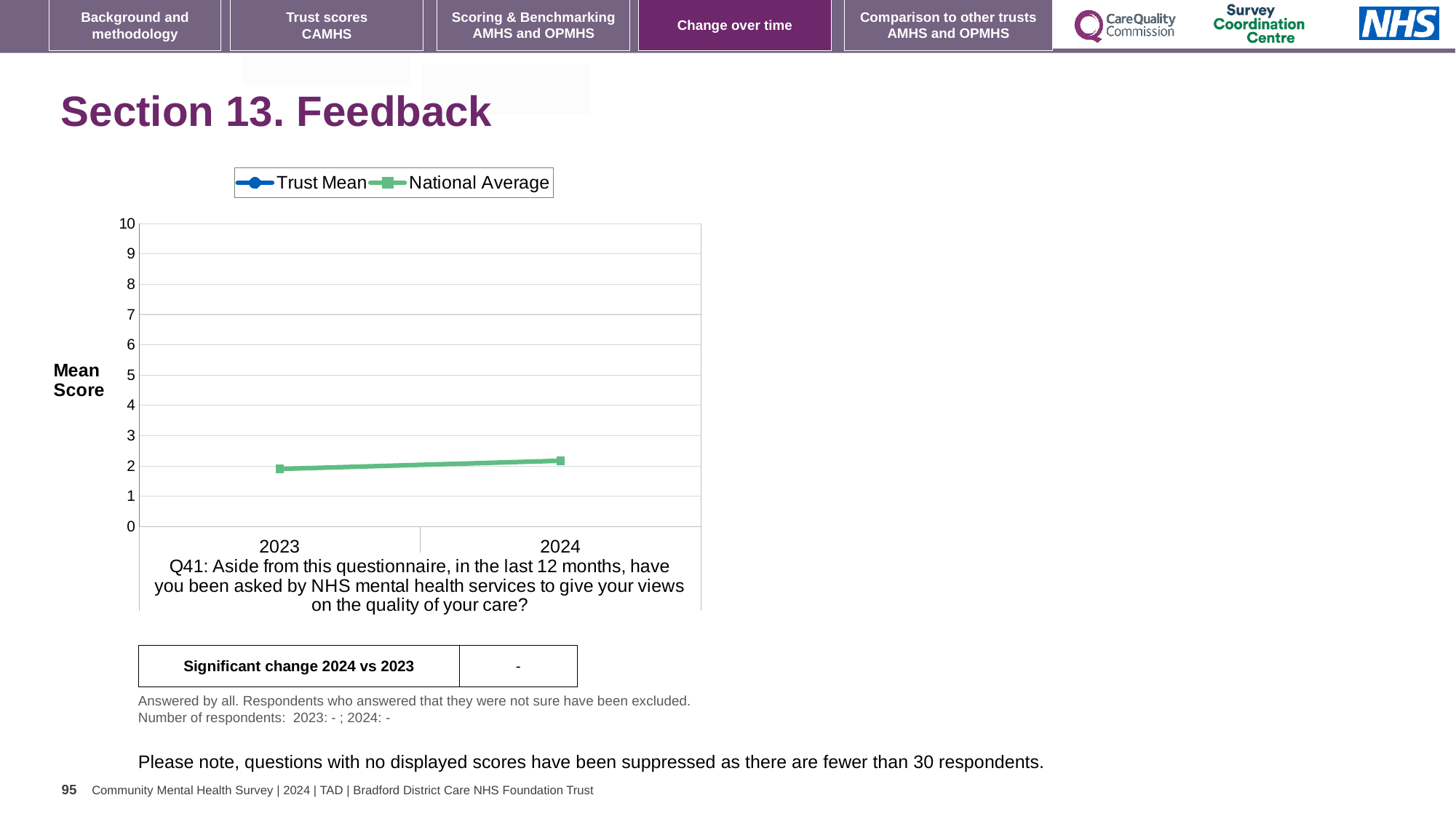
Is the National Average value for 2023 greater or less than 3? less Which year has the higher National Average value, 2023 or 2024? 2024 How many series does the chart legend list? 2 What is the highest value shown on the vertical axis of the chart? 10 Is the National Average value for 2024 greater or less than 3? less Which two series are listed in the chart legend? Trust Mean and National Average Does the National Average line rise or fall from 2023 to 2024? rise Is the National Average value for 2024 greater or less than 5? less What is the label on the vertical axis of the chart? Mean Score What kind of chart is shown on the slide? line chart How many years are shown on the x axis of the chart? 2